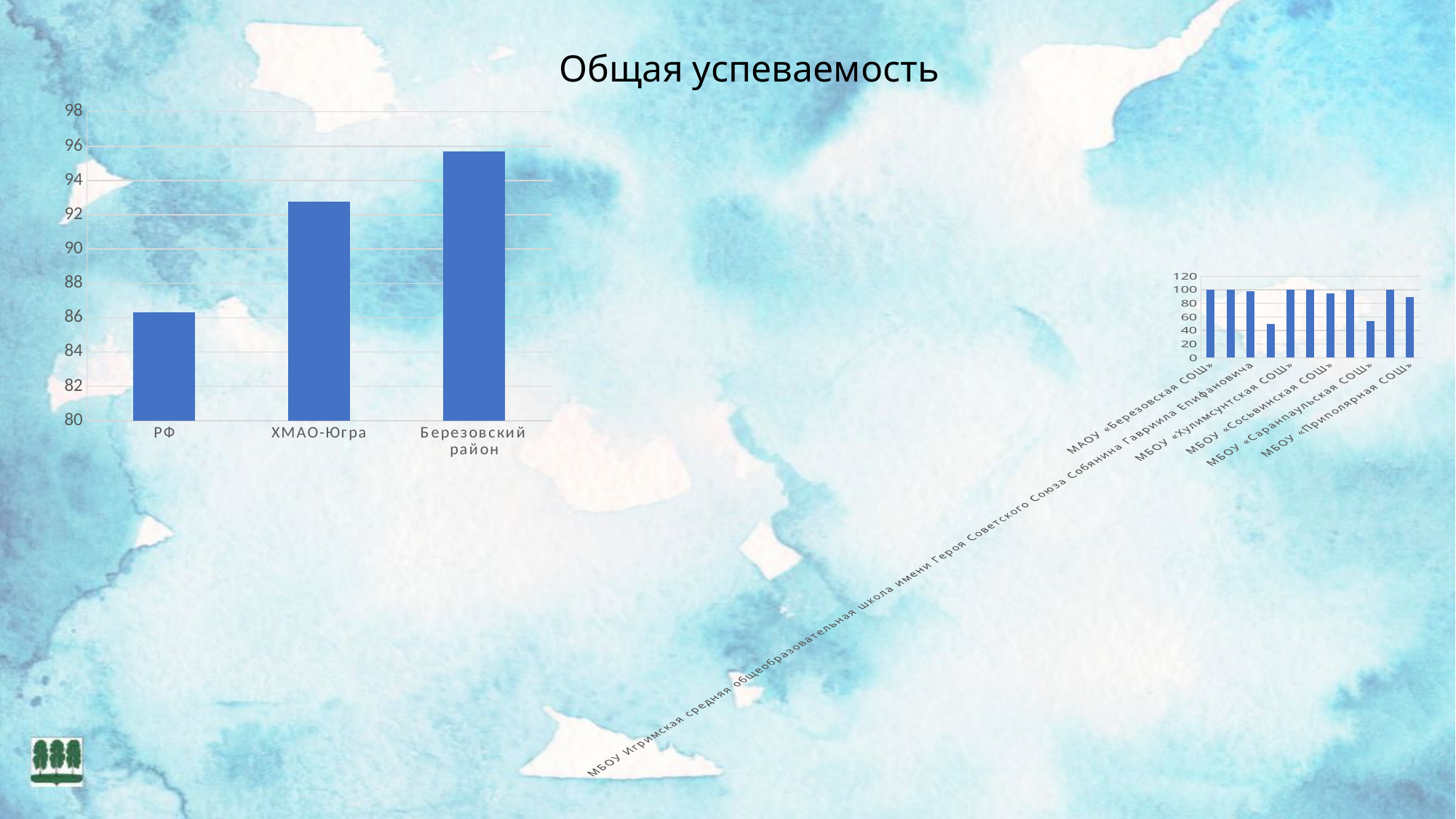
In the left chart, which category has the highest value? Березовский район In the left chart, how many categories are shown? 3 What is the title of the slide's main chart? Общая успеваемость What kind of chart is the small chart on the right side of the slide? bar chart In the left chart, which category has the lowest value? РФ What kind of chart is the left chart on the slide? bar chart In the left chart, is the value for РФ greater or less than 88? less In the small chart on the right, how many bars are plotted? 11 In the left chart, is the value for Березовский район greater or less than 94? greater In the left chart, which is larger, the value for РФ or the value for ХМАО-Югра? ХМАО-Югра In the left chart, is the value for ХМАО-Югра greater or less than 90? greater In the left chart, do the values rise or fall from left to right along the x axis? rise